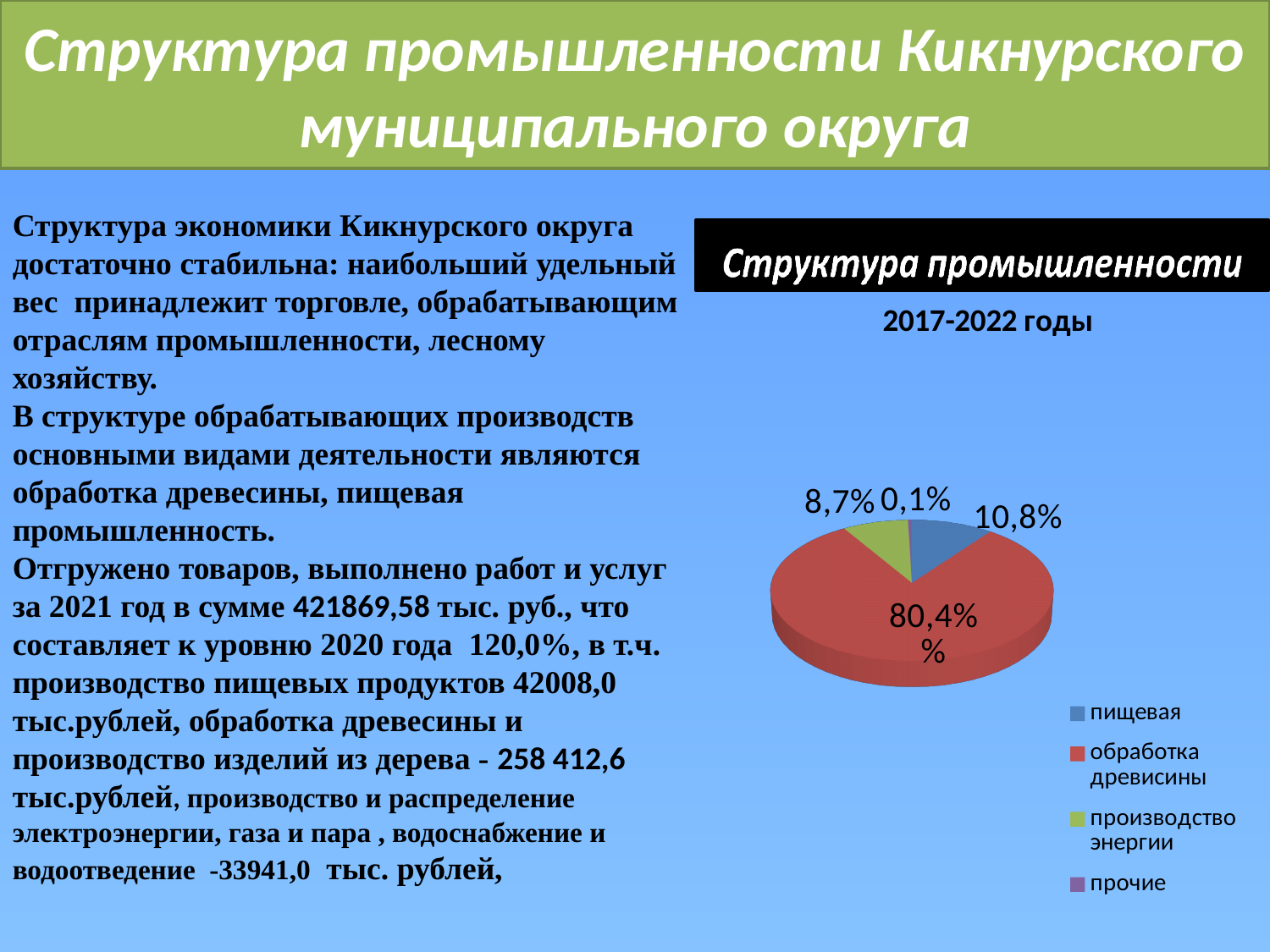
How many categories does the legend list? 4 What colour is the slice for обработка древисины? red What is the difference in percentage points between обработка древисины and пищевая? 69,6 What kind of chart is shown on the slide? pie chart Which category has the largest slice of the pie? обработка древисины What share of the pie does прочие have? 0,1% What share of the pie does обработка древисины have? 80,4% What period is given in the chart title? 2017-2022 годы Which category has the smallest slice of the pie? прочие Which is larger, the share for пищевая or the share for производство энергии? пищевая What share of the pie does производство энергии have? 8,7% What share of the pie does пищевая have? 10,8%